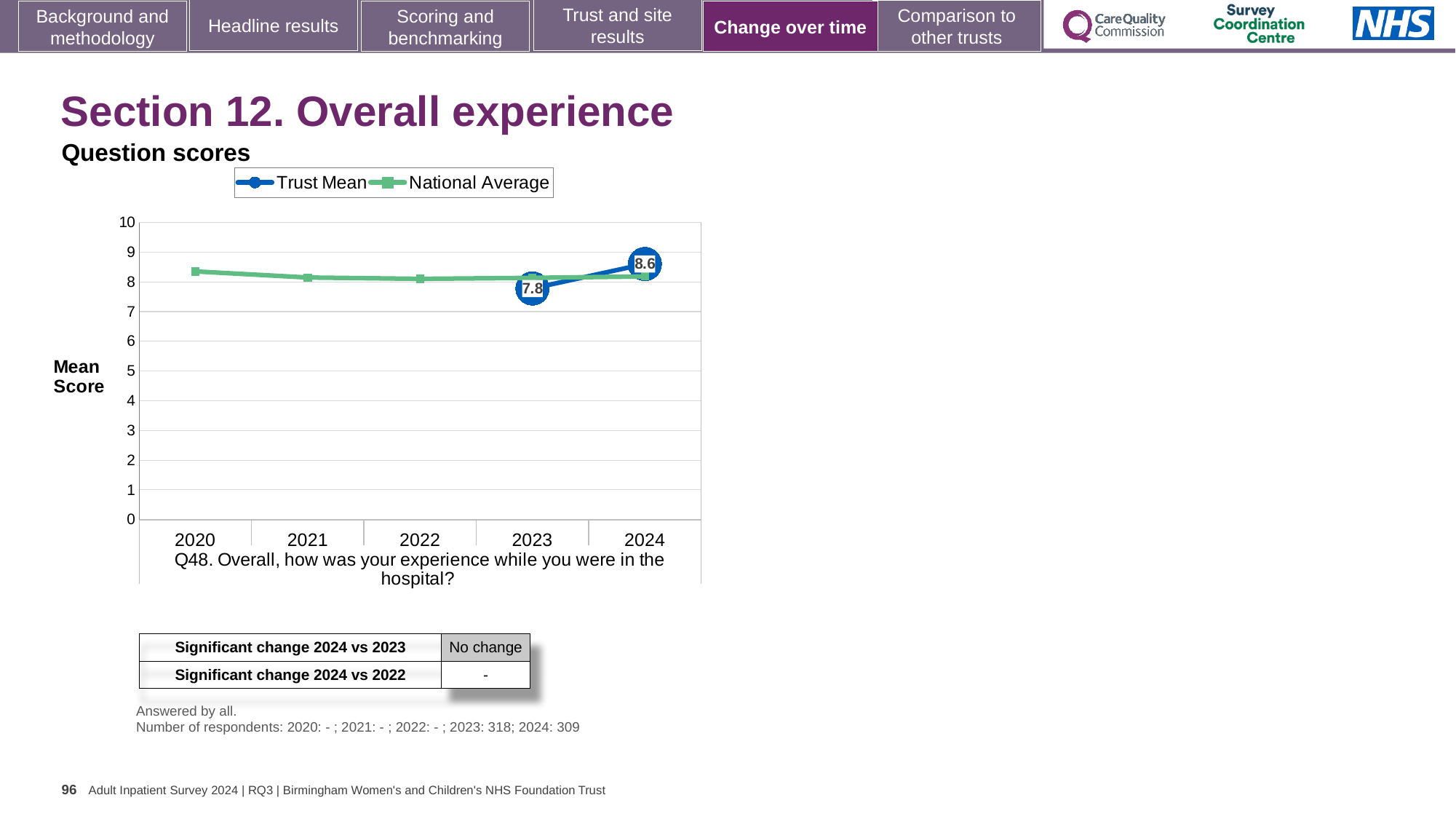
Is the National Average score for 2024 greater or less than 9? less Is the Trust Mean score for 2023 greater or less than 8? less How many years are shown on the x axis of the chart? 5 How many series does the chart legend list? 2 What type of chart is used to show the question scores? line chart What is the Trust Mean score for 2023? 7.8 What is the Trust Mean score for 2024? 8.6 By how much did the Trust Mean score change from 2023 to 2024? 0.8 Which question does the chart show scores for? Q48. Overall, how was your experience while you were in the hospital? Is the National Average score for 2020 greater or less than 7? greater In 2024, which is higher: the Trust Mean or the National Average? Trust Mean Did the Trust Mean score rise or fall from 2023 to 2024? rise